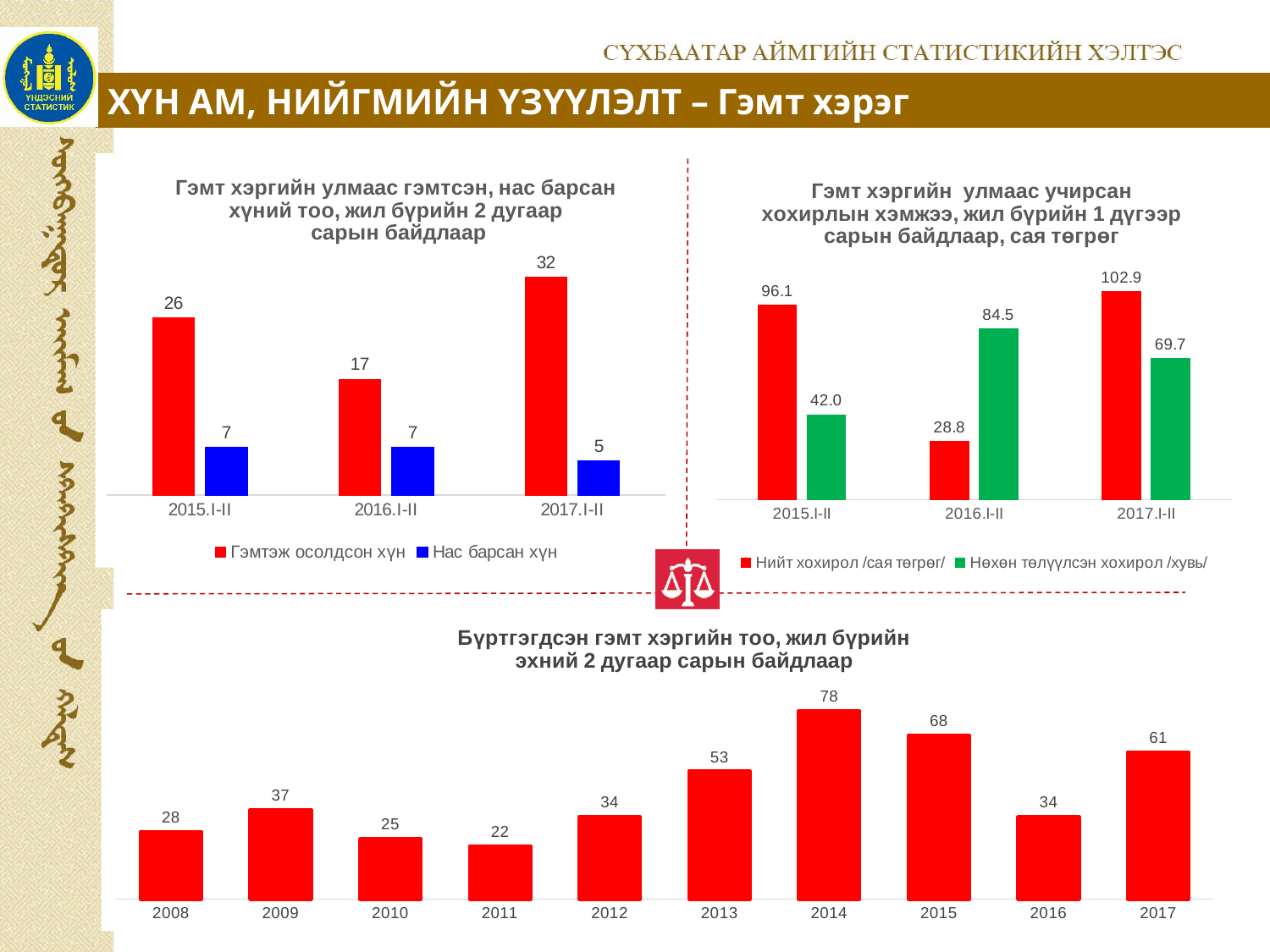
In the top-right chart (Гэмт хэргийн улмаас учирсан хохирлын хэмжээ), which is larger in 2016.I-II: Нийт хохирол or Нөхөн төлүүлсэн хохирол? Нөхөн төлүүлсэн хохирол In the bottom chart (Бүртгэгдсэн гэмт хэргийн тоо), which year has the lowest value? 2011 How many series does the legend of the top-right chart (Гэмт хэргийн улмаас учирсан хохирлын хэмжээ) list? 2 In the bottom chart (Бүртгэгдсэн гэмт хэргийн тоо), which year has the highest value? 2014 In the top-left chart (Гэмт хэргийн улмаас гэмтсэн, нас барсан хүний тоо), what is the difference between Гэмтэж осолдсон хүн in 2015.I-II and 2016.I-II? 9 How many years are shown on the x axis of the bottom chart (Бүртгэгдсэн гэмт хэргийн тоо)? 10 In the bottom chart (Бүртгэгдсэн гэмт хэргийн тоо), what is the difference between the values for 2017 and 2016? 27 In the top-left chart (Гэмт хэргийн улмаас гэмтсэн, нас барсан хүний тоо), what is the value for Гэмтэж осолдсон хүн in 2017.I-II? 32 In the top-right chart (Гэмт хэргийн улмаас учирсан хохирлын хэмжээ), which period has the lowest value for Нийт хохирол? 2016.I-II In the bottom chart (Бүртгэгдсэн гэмт хэргийн тоо), what is the value for 2014? 78 In the top-left chart (Гэмт хэргийн улмаас гэмтсэн, нас барсан хүний тоо), what is the value for Нас барсан хүн in 2017.I-II? 5 In the top-right chart (Гэмт хэргийн улмаас учирсан хохирлын хэмжээ), what is the value for Нийт хохирол in 2017.I-II? 102.9